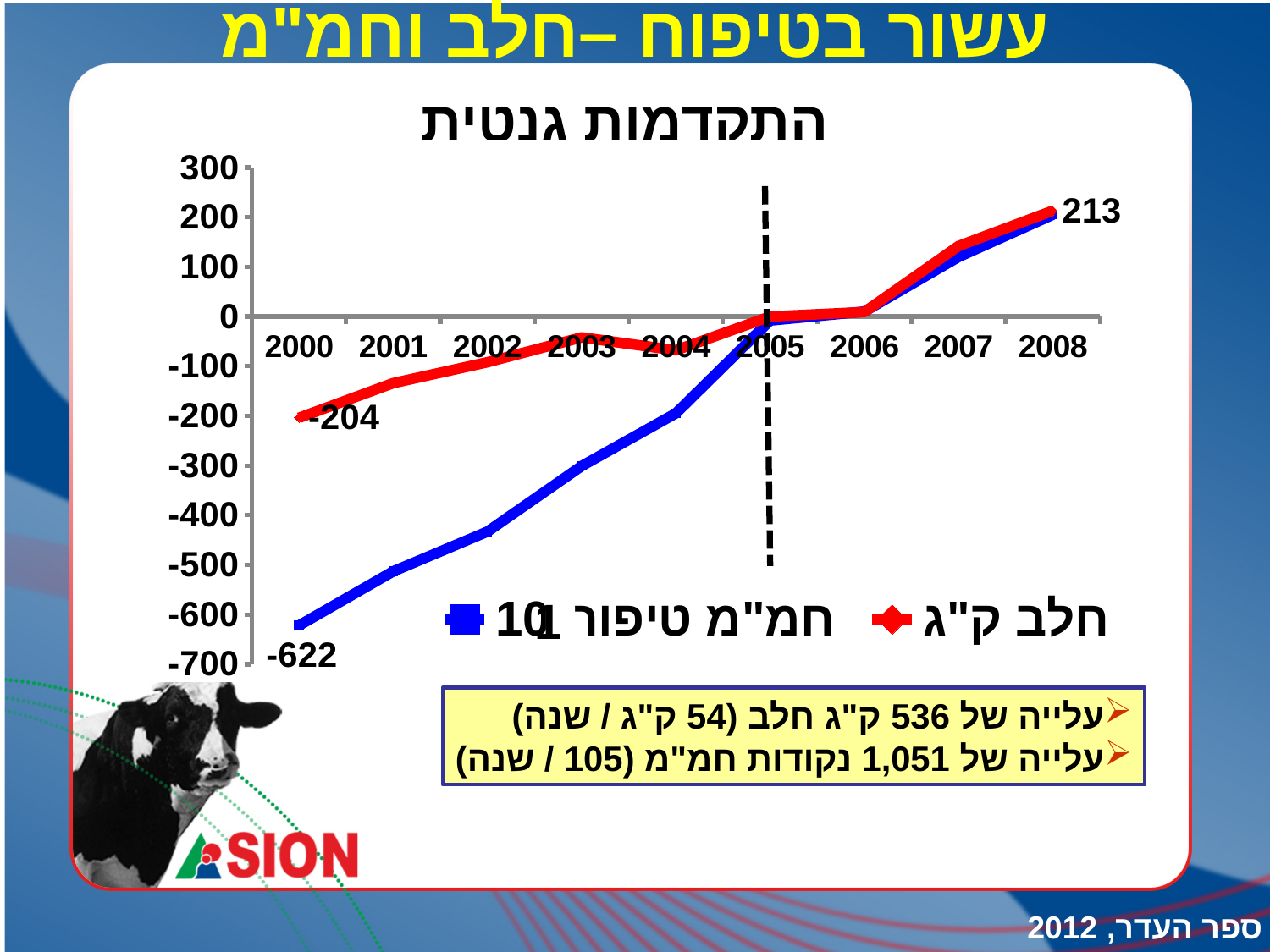
How many series does the chart's legend list? 2 What is the value of the red series (חלב ק"ג) in 2008? 213 Do the values of the blue series rise or fall from 2000 to 2008? rise What is the value of the red series (חלב ק"ג) in 2000? -204 What is the difference between the red series and the blue series in 2000? 418 How many years are plotted along the x axis of the chart? 9 What kind of chart is shown on the slide? line chart By how much did the red series (חלב ק"ג) increase from 2000 to 2008? 417 What is the title of the chart? התקדמות גנטית What is the value of the blue series in 2000? -622 Is the value of the red series (חלב ק"ג) in 2007 greater or less than 100? greater In 2000, which series has the higher value, the red (חלב ק"ג) or the blue? red (חלב ק"ג)